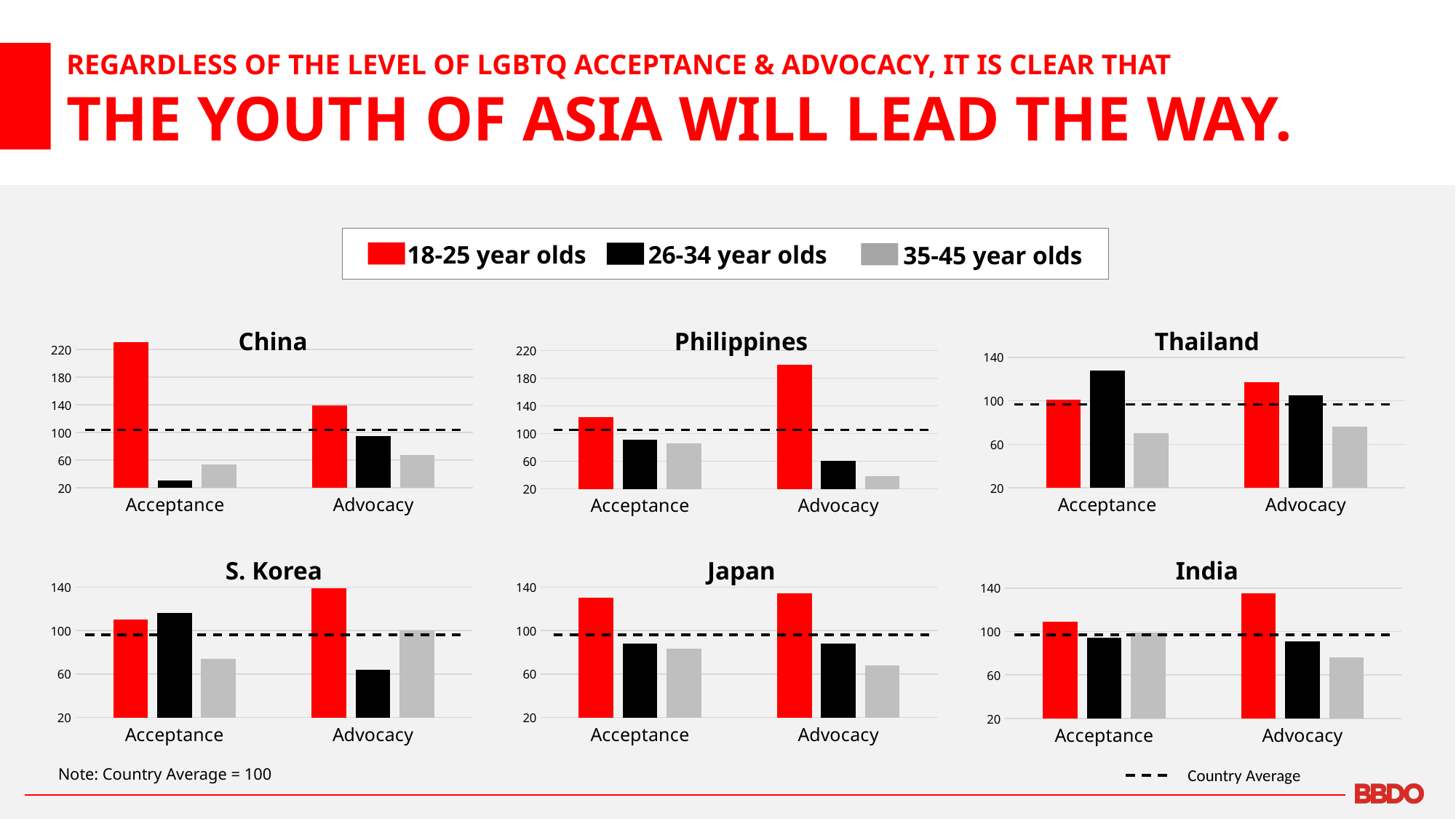
In the China chart, is the Acceptance value for 26-34 year olds greater or less than 60? less How many country charts are shown on the slide? 6 In the Philippines chart, which age group has the lowest value for Advocacy? 35-45 year olds What kind of chart is the China chart? bar chart In the Japan chart, which is larger for Advocacy: the value for 18-25 year olds or the value for 35-45 year olds? 18-25 year olds In the China chart, is the Acceptance value for 18-25 year olds greater or less than 180? greater How many series does the legend list for the charts on this slide? 3 What does the dashed horizontal line in each chart represent? Country Average In the Thailand chart, which age group has the highest value for Acceptance? 26-34 year olds In the Philippines chart, is the Advocacy value for 18-25 year olds greater or less than 180? greater In the China chart, which age group has the highest value for Acceptance? 18-25 year olds